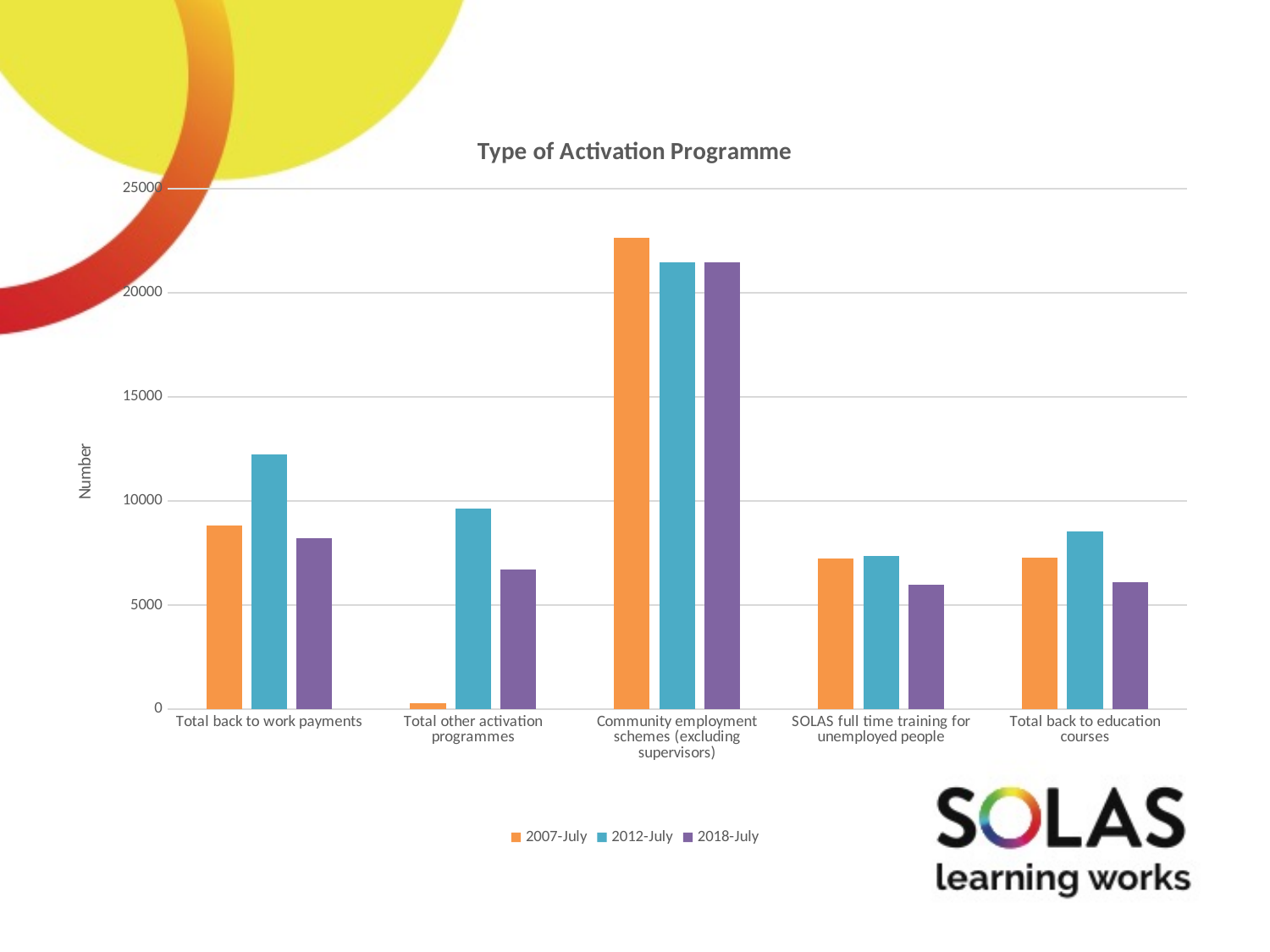
Is the 2007-July value for Community employment schemes (excluding supervisors) greater or less than 20000? greater Is the 2012-July value for Total back to work payments greater or less than 10000? greater For Total back to work payments, which is larger: the 2012-July value or the 2018-July value? 2012-July What kind of chart is shown on the slide? bar chart Which category has the highest value for 2007-July? Community employment schemes (excluding supervisors) What is the title of the chart? Type of Activation Programme Which category has the lowest value for 2007-July? Total other activation programmes For Total other activation programmes, which is larger: the 2007-July value or the 2012-July value? 2012-July Which series has the highest value for Total back to education courses? 2012-July How many series does the legend list? 3 Is the 2018-July value for Total other activation programmes greater or less than 5000? greater How many categories are shown on the x axis? 5